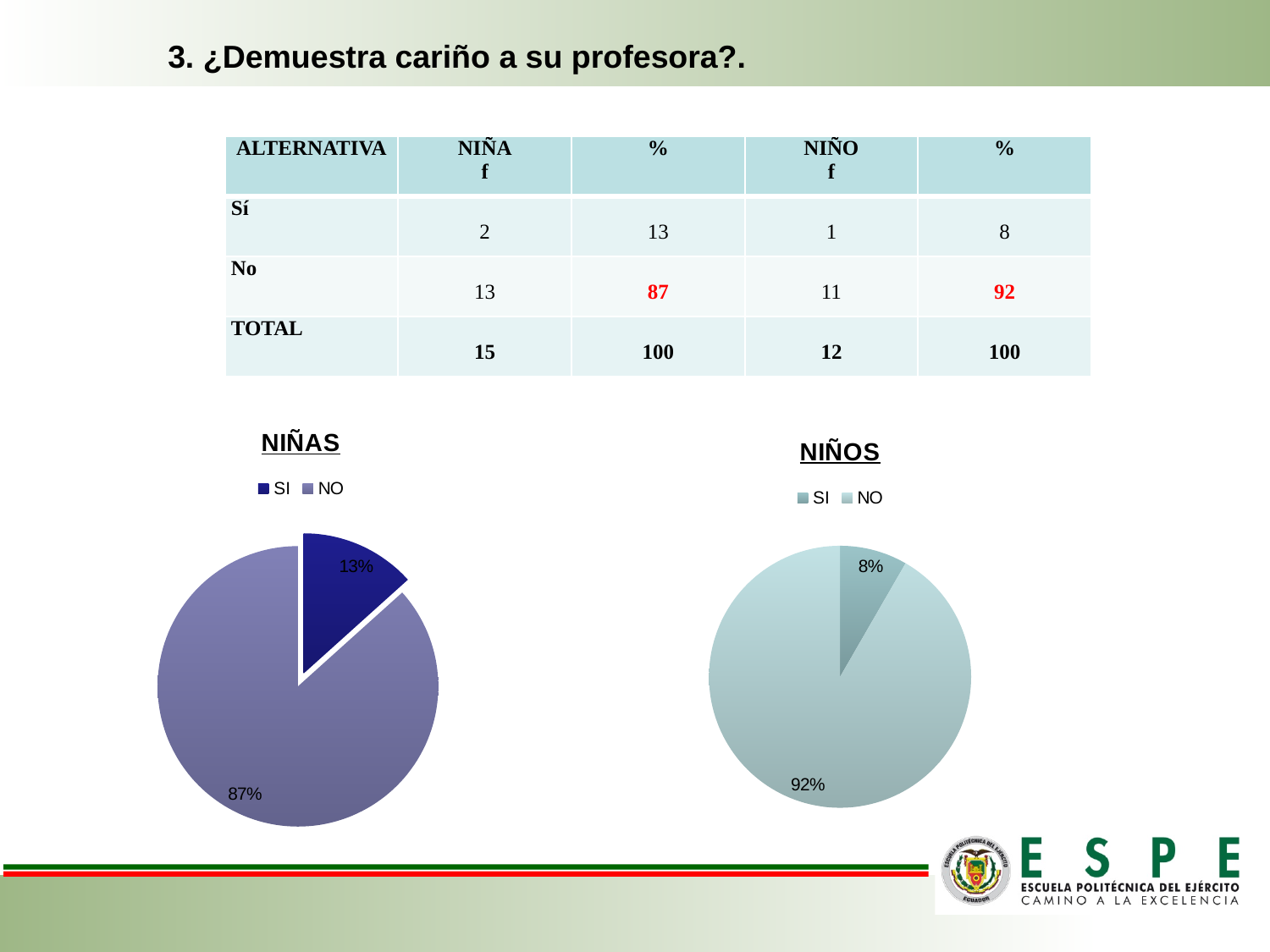
In the NIÑAS pie chart, which slice is the largest? NO In the NIÑOS pie chart, which slice is the smallest? SI How many entries does the legend of the NIÑOS chart list? 2 In the NIÑAS pie chart, what is the difference between the NO and SI percentages? 74% What is the title of the pie chart on the left? NIÑAS In the NIÑOS pie chart, what percentage is shown for SI? 8% In the NIÑAS pie chart, what percentage is shown for NO? 87% In the NIÑOS pie chart, what percentage is shown for NO? 92% In the NIÑAS pie chart, what percentage is shown for SI? 13% What type of chart is the NIÑOS chart? Pie chart Which is larger: the SI share in the NIÑAS chart or the SI share in the NIÑOS chart? NIÑAS How many slices does the NIÑAS pie chart have? 2